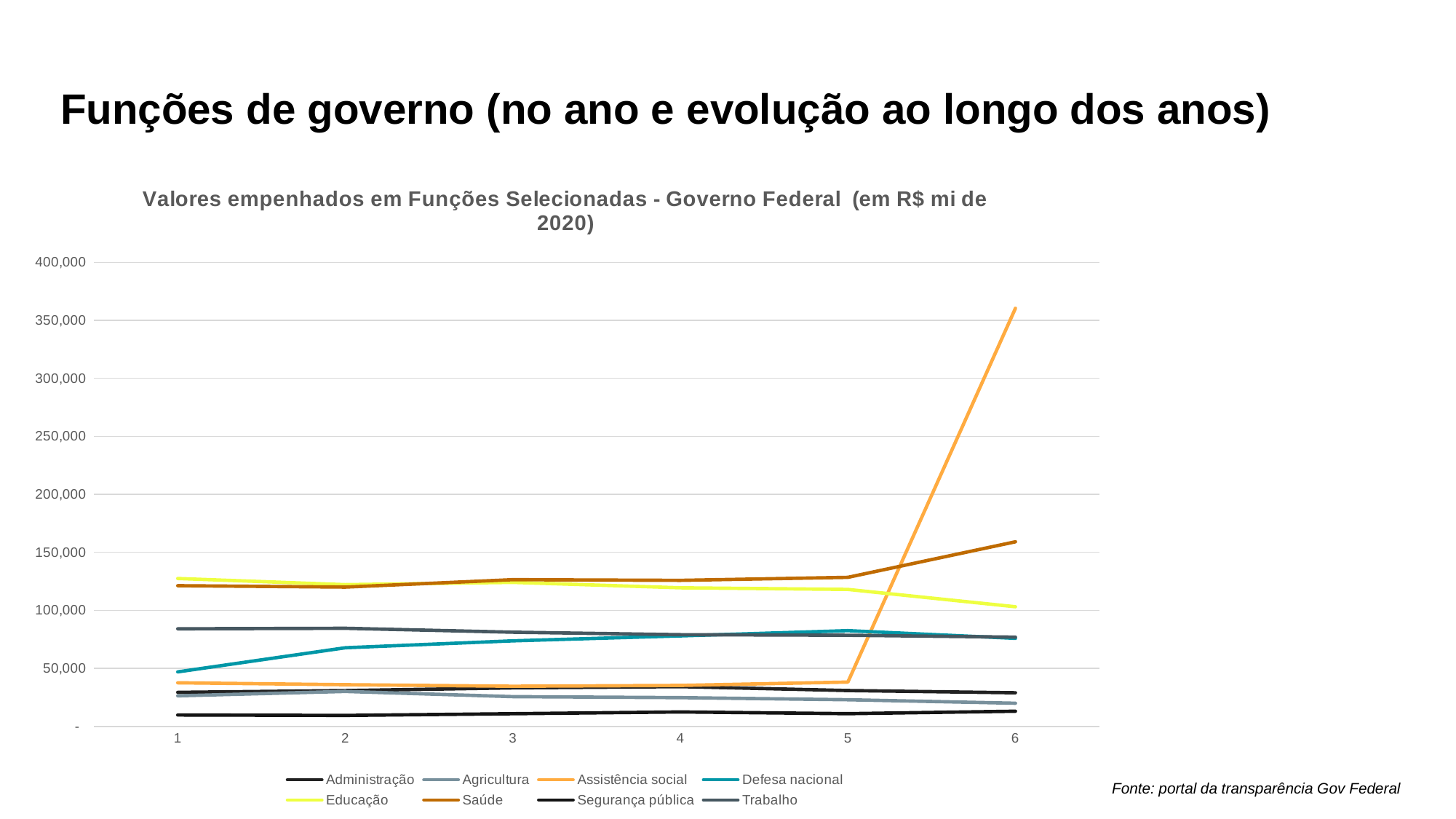
Is the value for Saúde at point 6 greater or less than 100,000? greater Does the Educação line rise or fall between point 5 and point 6? fall At point 6, which is larger: Saúde or Educação? Saúde Does the Assistência social line rise or fall between point 5 and point 6? rise How many points are there along the x axis? 6 What kind of chart is shown on the slide? line chart Is the value for Assistência social at point 6 greater or less than 300,000? greater How many series does the legend list? 8 Is the value for Trabalho at point 1 greater or less than 100,000? less Which series has the highest value at point 6? Assistência social What is the title of the chart? Valores empenhados em Funções Selecionadas - Governo Federal (em R$ mi de 2020) Which series has the lowest value at point 6? Segurança pública